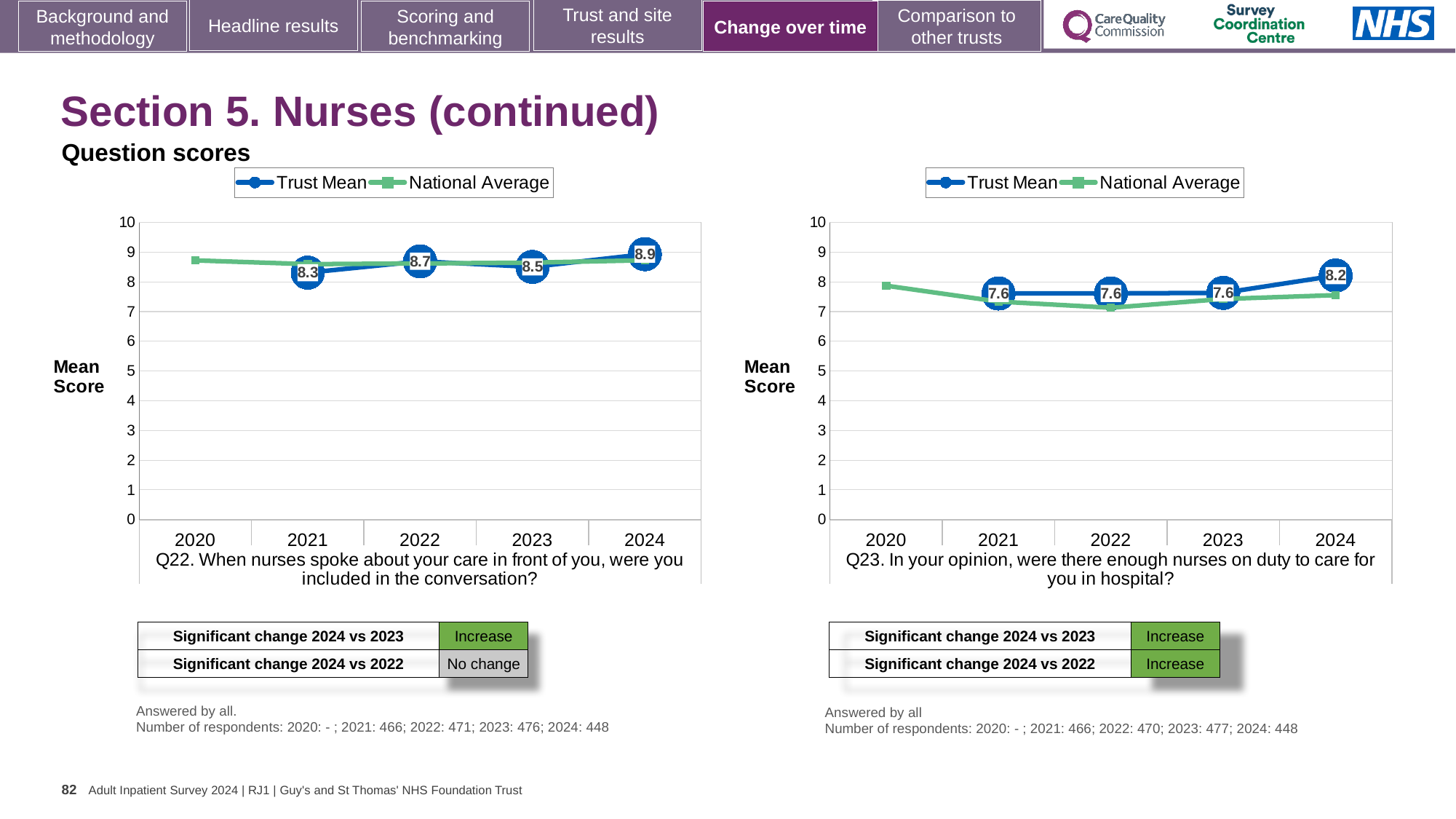
How many series does the legend of the Q23 chart (right) list? 2 In the Q22 chart (left), what is the Trust Mean score for 2021? 8.3 In the Q23 chart (right), what is the Trust Mean score for 2024? 8.2 In the Q22 chart (left), what is the difference between the Trust Mean scores for 2024 and 2021? 0.6 In the Q23 chart (right), what is the Trust Mean score for 2022? 7.6 In the Q22 chart (left), which year has the highest Trust Mean score? 2024 In the Q22 chart (left), what is the Trust Mean score for 2024? 8.9 In the Q23 chart (right), is the National Average for 2022 greater or less than 8? less In the Q22 chart (left), is the Trust Mean score for 2022 higher or lower than for 2023? higher In the Q22 chart (left), which year has the lowest labelled Trust Mean score? 2021 In the Q23 chart (right), what is the difference between the Trust Mean scores for 2024 and 2023? 0.6 What kind of chart is the Q22 chart (left)? line chart